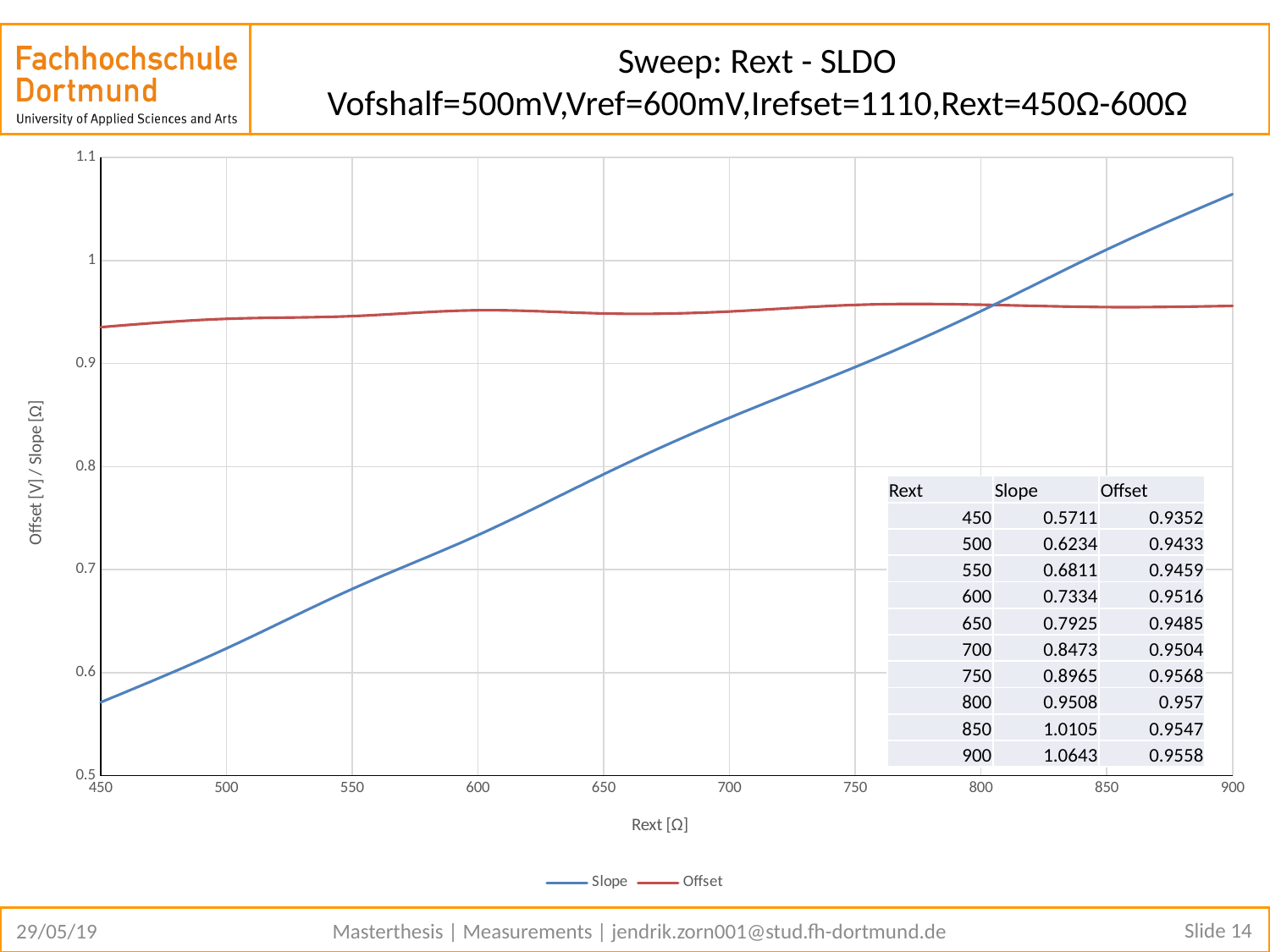
At which Rext value is the Slope highest? 900 How many series does the legend list? 2 Is the Slope value at Rext = 700 greater or less than 0.9? less At Rext = 850, which series has the larger value, Slope or Offset? Slope What kind of chart is shown on the slide? line chart What is the Slope value at Rext = 600? 0.7334 What is the Offset value at Rext = 800? 0.957 At which Rext value is the Offset lowest? 450 What is the difference between the Slope at Rext = 900 and the Slope at Rext = 450? 0.4932 How many Rext data points are plotted for each series? 10 What is the label of the vertical axis? Offset [V] / Slope [Ω] Does the Slope series rise or fall as Rext increases from 450 to 900? rises